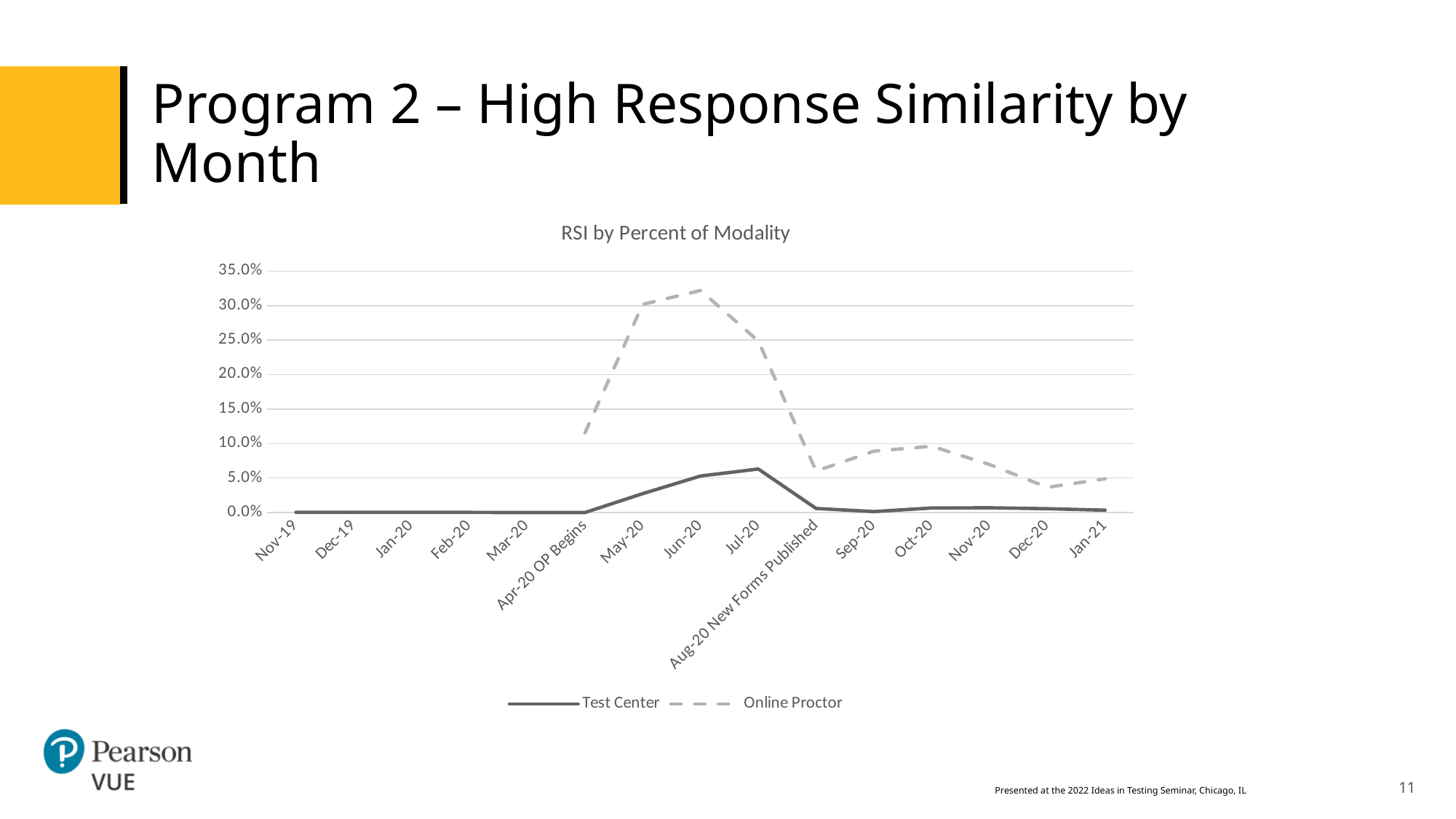
What kind of chart is shown on the slide? Line chart In which month does the Online Proctor series reach its highest value? Jun-20 In which month does the Test Center series reach its highest value? Jul-20 Is the Online Proctor value for Jun-20 greater or less than 30.0%? greater What is the title of the chart? RSI by Percent of Modality Is the Online Proctor value for Aug-20 New Forms Published greater or less than 10.0%? less Does the Online Proctor series rise or fall from Jun-20 to Aug-20 New Forms Published? Fall Is the Test Center value for Jul-20 greater or less than 5.0%? greater Which series has the larger value in Jun-20, Test Center or Online Proctor? Online Proctor How many series does the legend list? 2 Which series is drawn with a dashed line? Online Proctor How many months are plotted along the x axis? 15